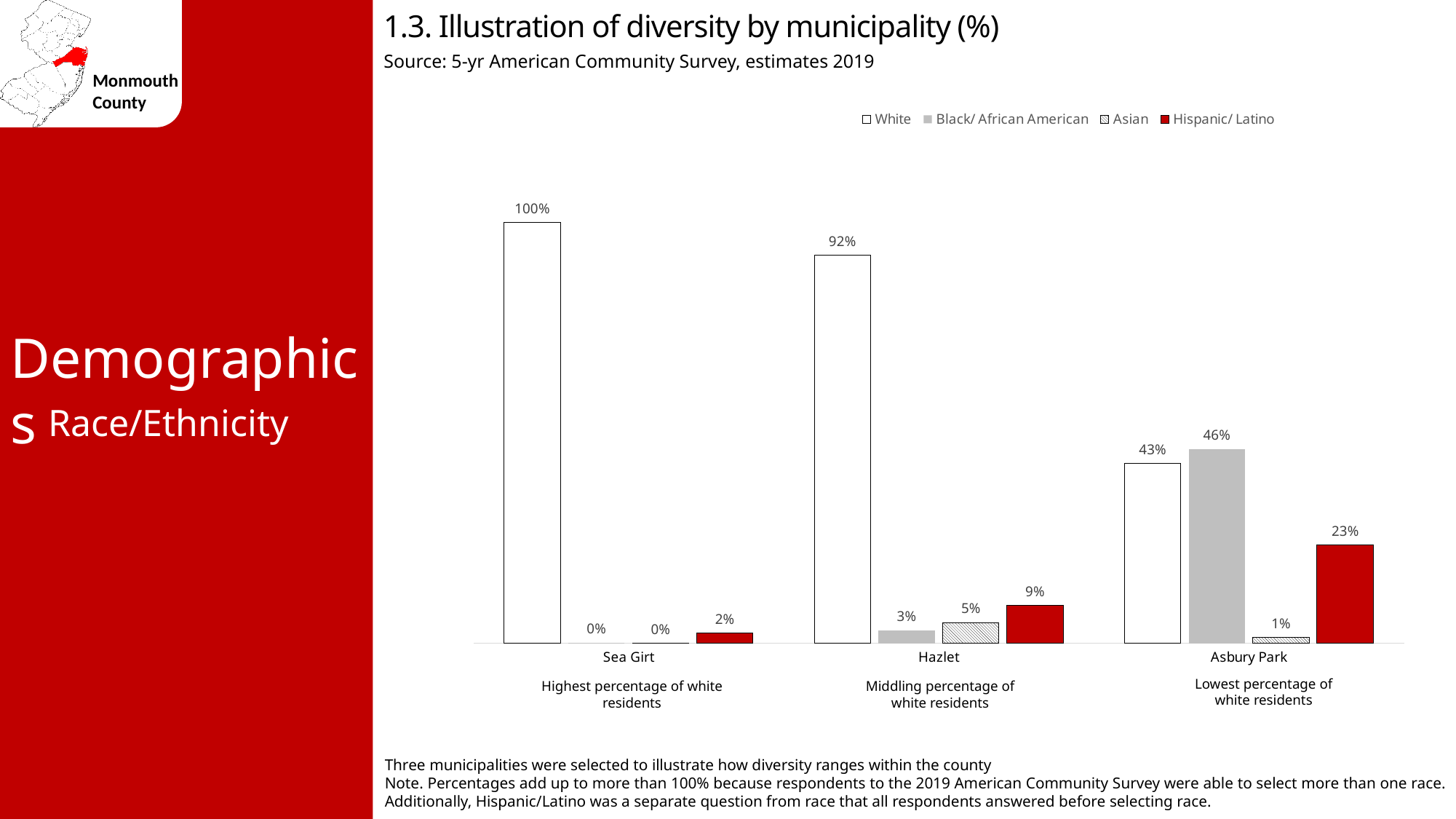
Which municipality has the highest White percentage? Sea Girt What kind of chart is shown on the slide? Bar chart What is the White percentage for Sea Girt? 100% Which is larger for Asbury Park: the White percentage or the Black/ African American percentage? Black/ African American Which municipality has the lowest White percentage? Asbury Park What is the difference between the White percentage for Sea Girt and for Hazlet? 8% How many series does the legend list? 4 What colour are the Hispanic/ Latino bars? Red What is the Hispanic/ Latino percentage for Asbury Park? 23% What is the Asian percentage for Hazlet? 5% How many municipalities are shown on the chart? 3 What is the Black/ African American percentage for Asbury Park? 46%